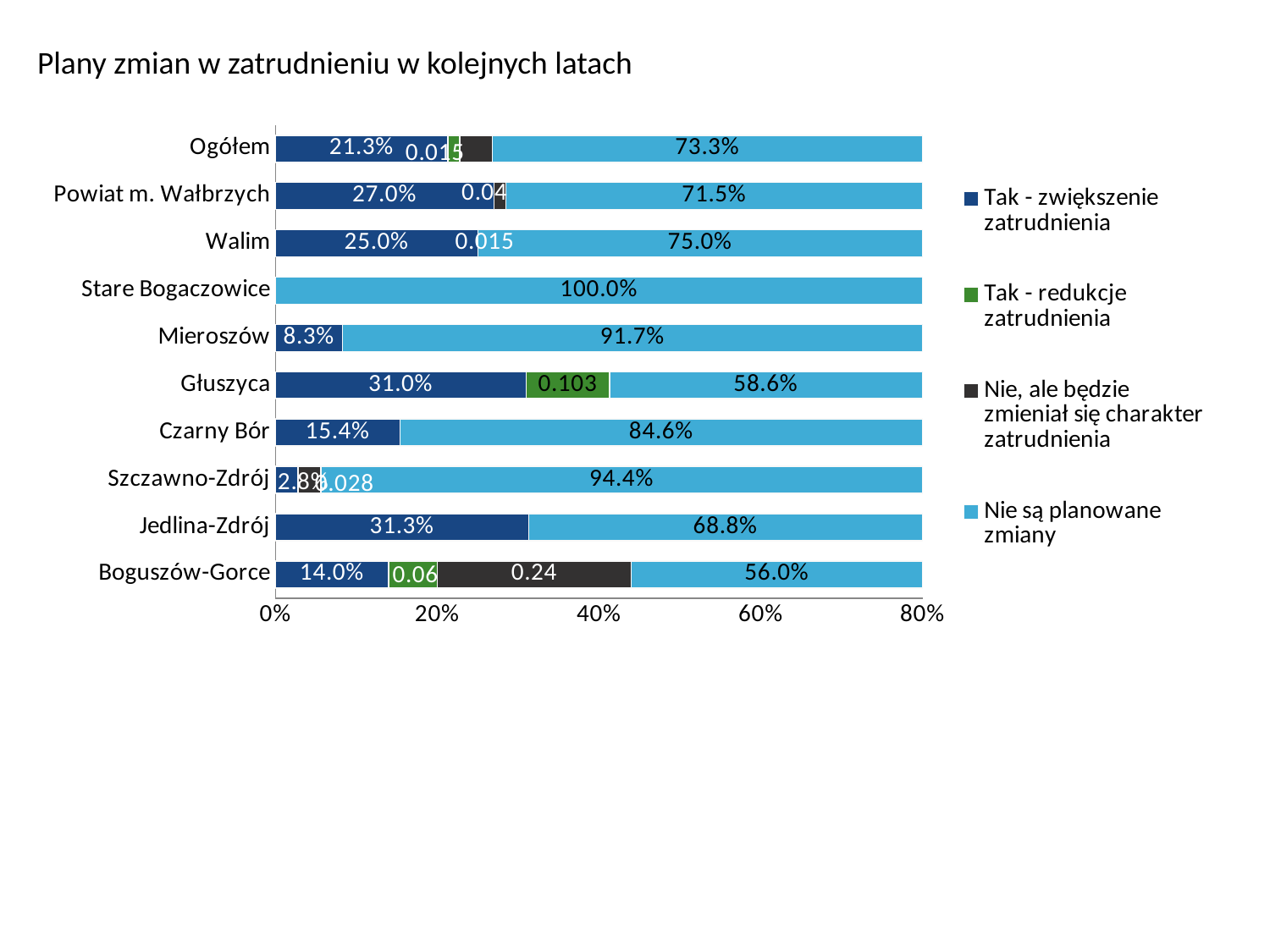
What is the value for "Tak - zwiększenie zatrudnienia" for Mieroszów? 8.3% What is the value for "Nie, ale będzie zmieniał się charakter zatrudnienia" for Boguszów-Gorce? 0.24 Which category has the highest value for "Nie są planowane zmiany"? Stare Bogaczowice How many categories are shown on the y axis of the chart? 10 What kind of chart is shown on the slide? Stacked bar chart Which category has the lowest value for "Nie są planowane zmiany"? Boguszów-Gorce Which has a larger "Nie są planowane zmiany" value, Mieroszów or Szczawno-Zdrój? Szczawno-Zdrój How many series does the legend list? 4 What is the value for "Nie są planowane zmiany" for Boguszów-Gorce? 56.0% What is the difference between the "Nie są planowane zmiany" values for Czarny Bór and Jedlina-Zdrój? 15.8 percentage points What is the value for "Tak - zwiększenie zatrudnienia" for Głuszyca? 31.0% What is the value for "Nie są planowane zmiany" for Stare Bogaczowice? 100.0%